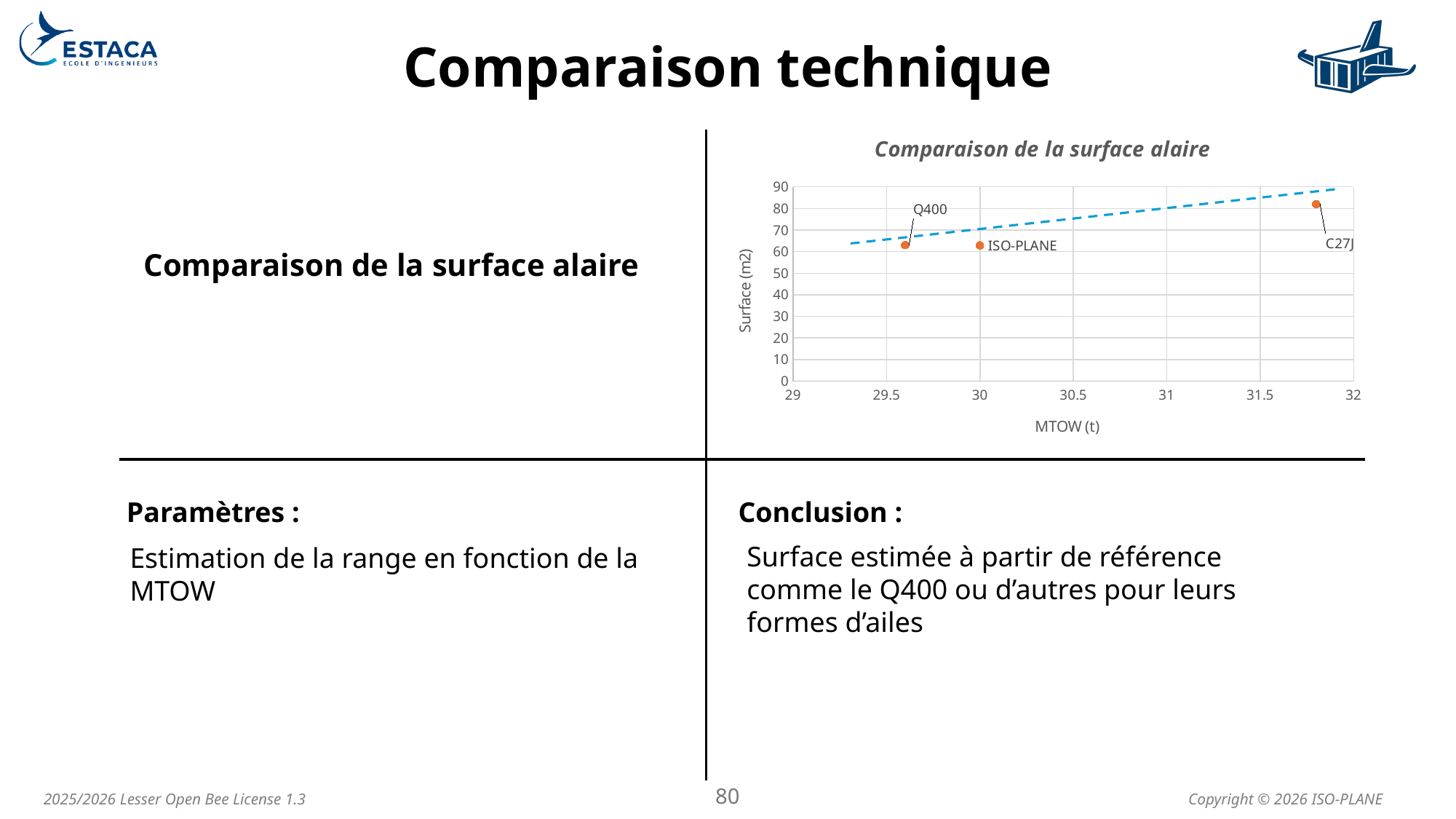
What is the label of the x axis of the chart? MTOW (t) Which has a larger wing surface, C27J or ISO-PLANE? C27J How many labelled data points are plotted on the chart? 3 Does the dashed trend line rise or fall as MTOW increases? rises Which aircraft has the lowest MTOW on the chart? Q400 What is the title of the chart? Comparaison de la surface alaire Is the surface value for ISO-PLANE greater or less than 70? less Which aircraft has the highest wing surface on the chart? C27J Is the surface value for Q400 greater or less than 70? less What kind of chart is shown on the slide? scatter chart Is the surface value for C27J greater or less than 70? greater Which aircraft has the highest MTOW on the chart? C27J